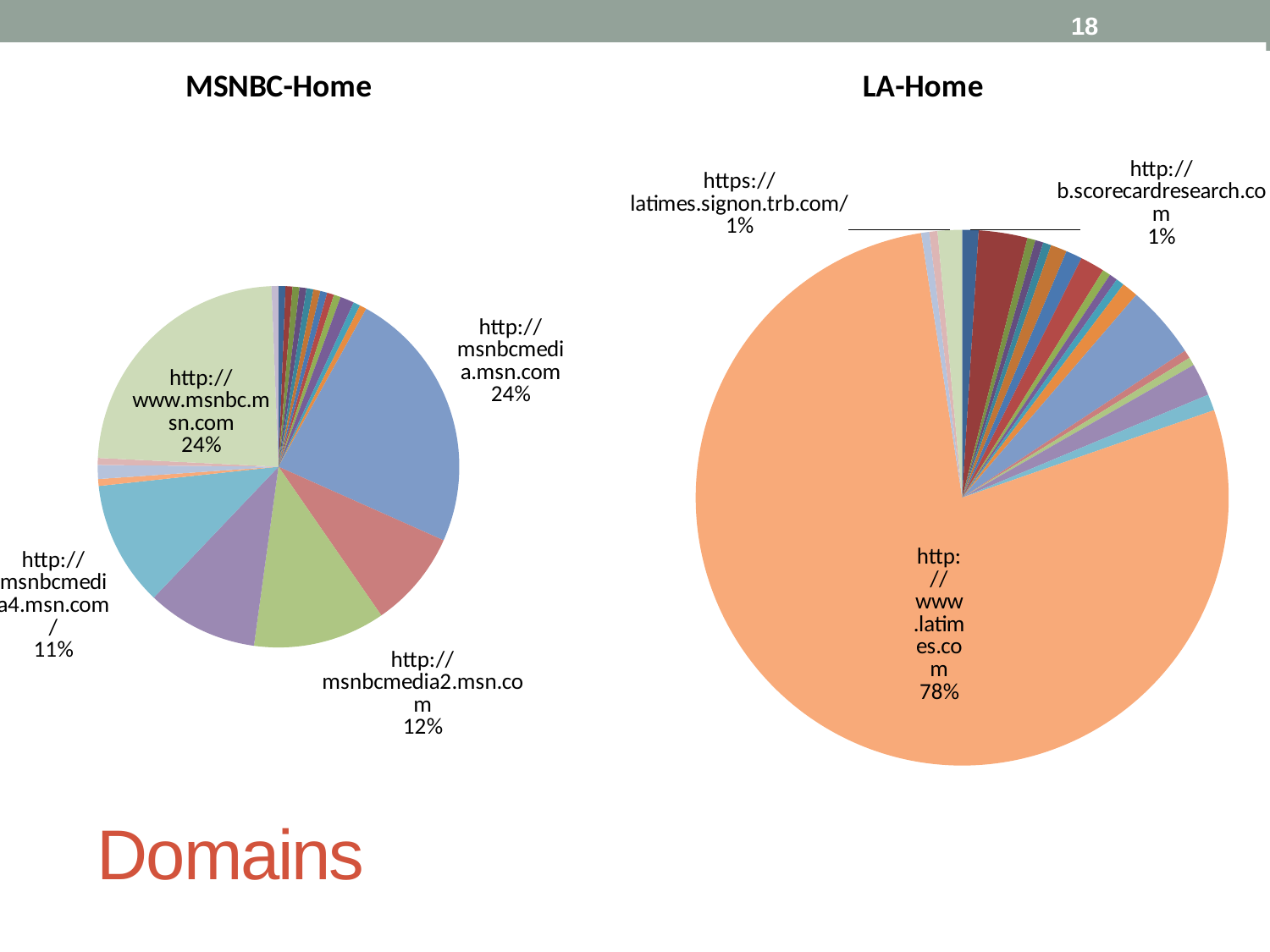
What are the titles of the two charts on the slide? MSNBC-Home and LA-Home What kind of chart is used for LA-Home? Pie chart In the MSNBC-Home pie chart, what share is labelled for http://msnbcmedia.msn.com? 24% In the LA-Home pie chart, which domain has the largest slice? http://www.latimes.com In the MSNBC-Home pie chart, which has the larger share, http://msnbcmedia2.msn.com or http://msnbcmedia4.msn.com/? http://msnbcmedia2.msn.com In the MSNBC-Home pie chart, what share is labelled for http://msnbcmedia4.msn.com/? 11% In the MSNBC-Home pie chart, what share is labelled for http://msnbcmedia2.msn.com? 12% In the LA-Home pie chart, what share is labelled for http://b.scorecardresearch.com? 1% In the MSNBC-Home pie chart, what share is labelled for http://www.msnbc.msn.com? 24% In the LA-Home pie chart, what share is labelled for http://www.latimes.com? 78% In the MSNBC-Home pie chart, what is the difference in percentage points between the share for http://msnbcmedia.msn.com and the share for http://msnbcmedia2.msn.com? 12 In the LA-Home pie chart, what share is labelled for https://latimes.signon.trb.com/? 1%